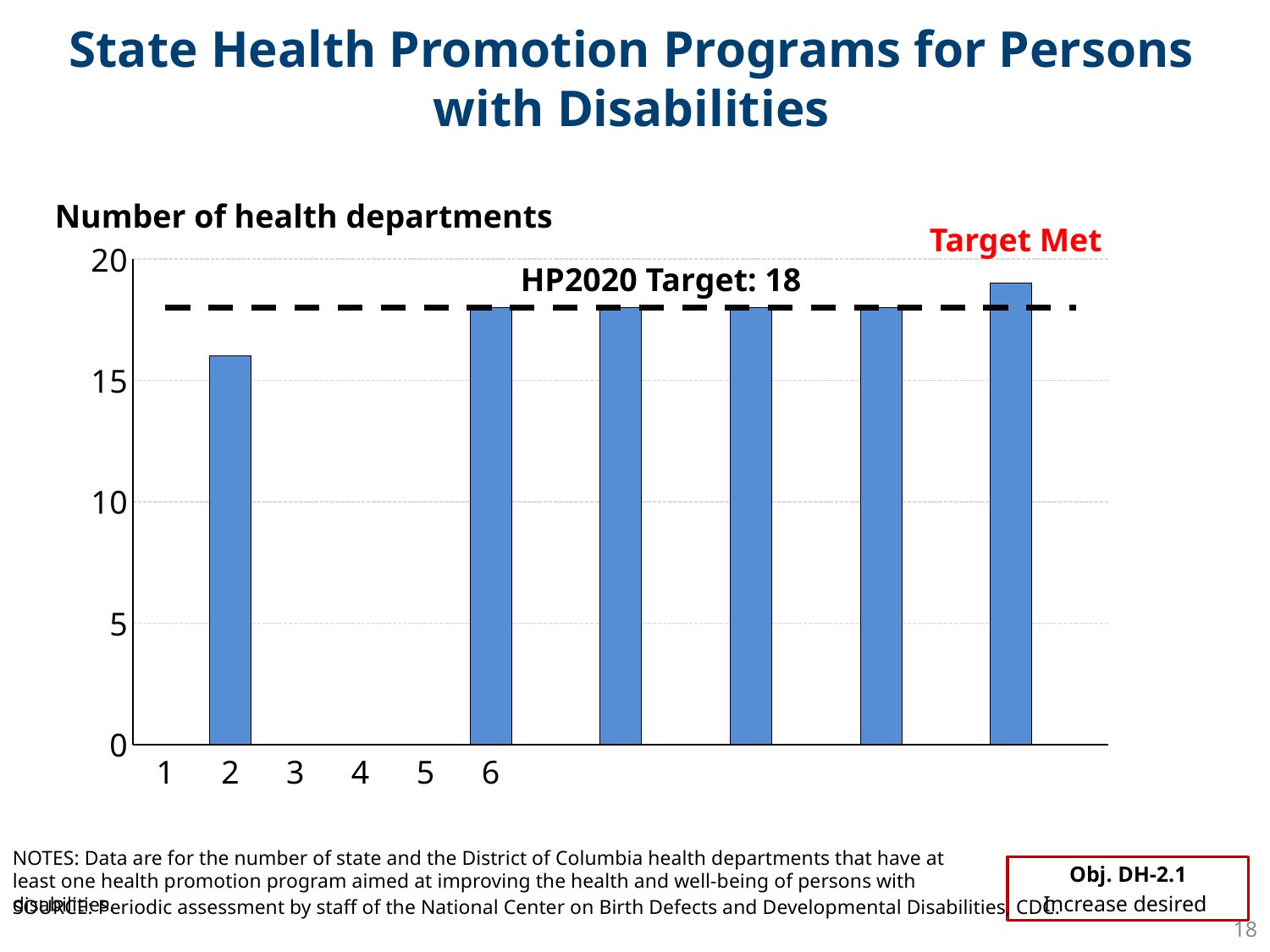
Which is larger, the first (leftmost) bar or the last (rightmost) bar? the last (rightmost) bar Is the first (leftmost) bar above or below the HP2020 target line? below What is the HP2020 target value shown on the chart? 18 Is the value of the first (leftmost) bar greater or less than 15? greater What does the y-axis of the chart measure? Number of health departments Which bar is the lowest in the chart? the first (leftmost) bar What kind of chart is shown on the slide? bar chart Do the bar values generally rise or fall from left to right across the chart? rise Which bar is the highest in the chart? the last (rightmost) bar How many bars are plotted in the chart? 6 Is the value of the last (rightmost) bar greater or less than 15? greater Is the value of the first (leftmost) bar greater or less than 20? less